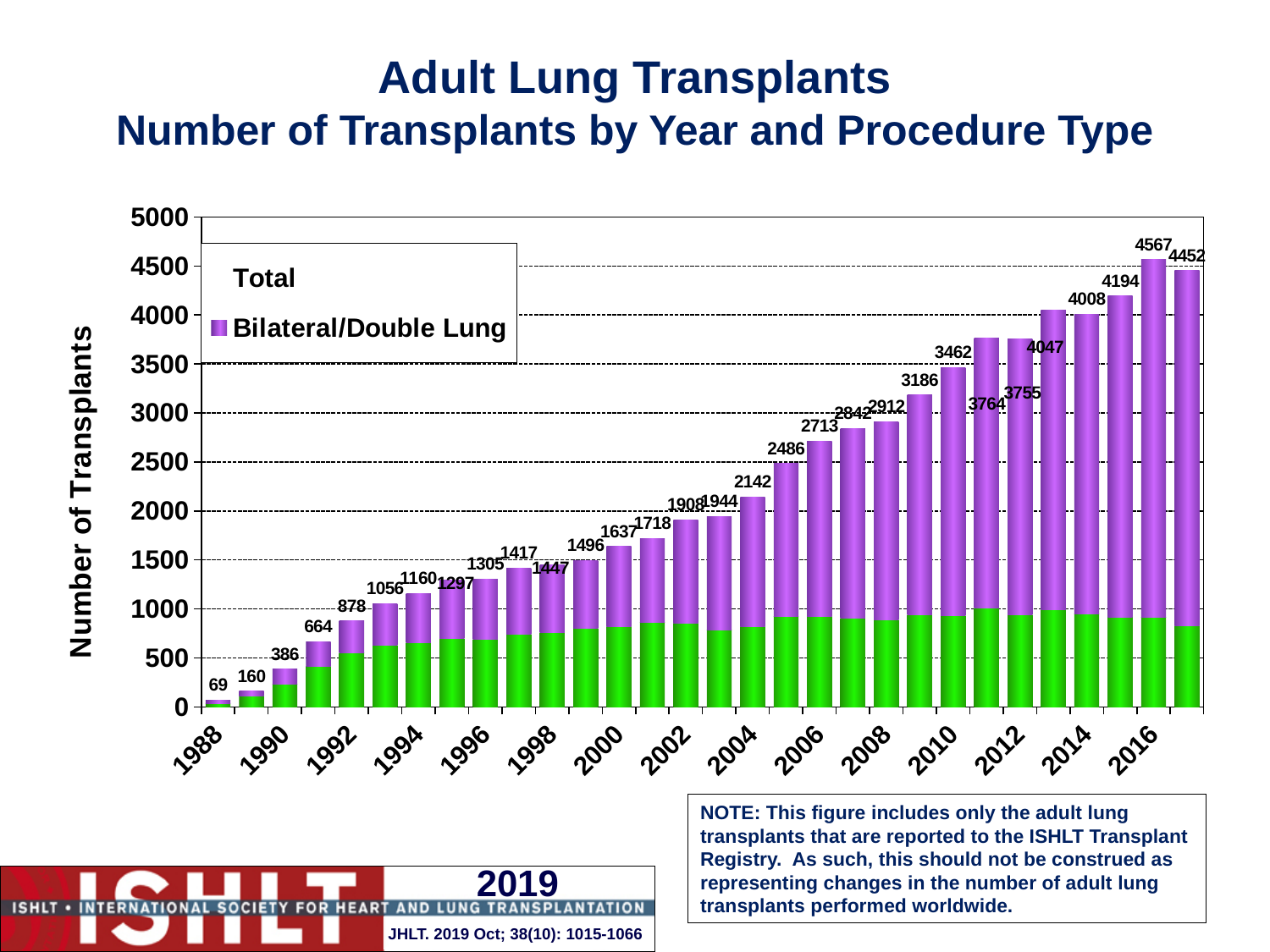
What is the total number of adult lung transplants labeled for 2000? 1637 What is the total number of adult lung transplants labeled for 2010? 3462 What is the label on the vertical axis? Number of Transplants What is the total number of adult lung transplants labeled for 2016? 4567 Which year has the highest total number of transplants? 2016 Which year has a larger total, 2009 or 2010? 2010 What type of chart is shown on the slide? bar chart Do the total transplant numbers generally rise or fall from 1988 to 2016? rise Which year has the lowest total number of transplants? 1988 What is the total number of adult lung transplants labeled for 1988? 69 Is the green (bottom) segment of the 2000 bar greater or less than 1000? less What is the difference between the total for 2016 (4567) and the total for 2017 (4452)? 115